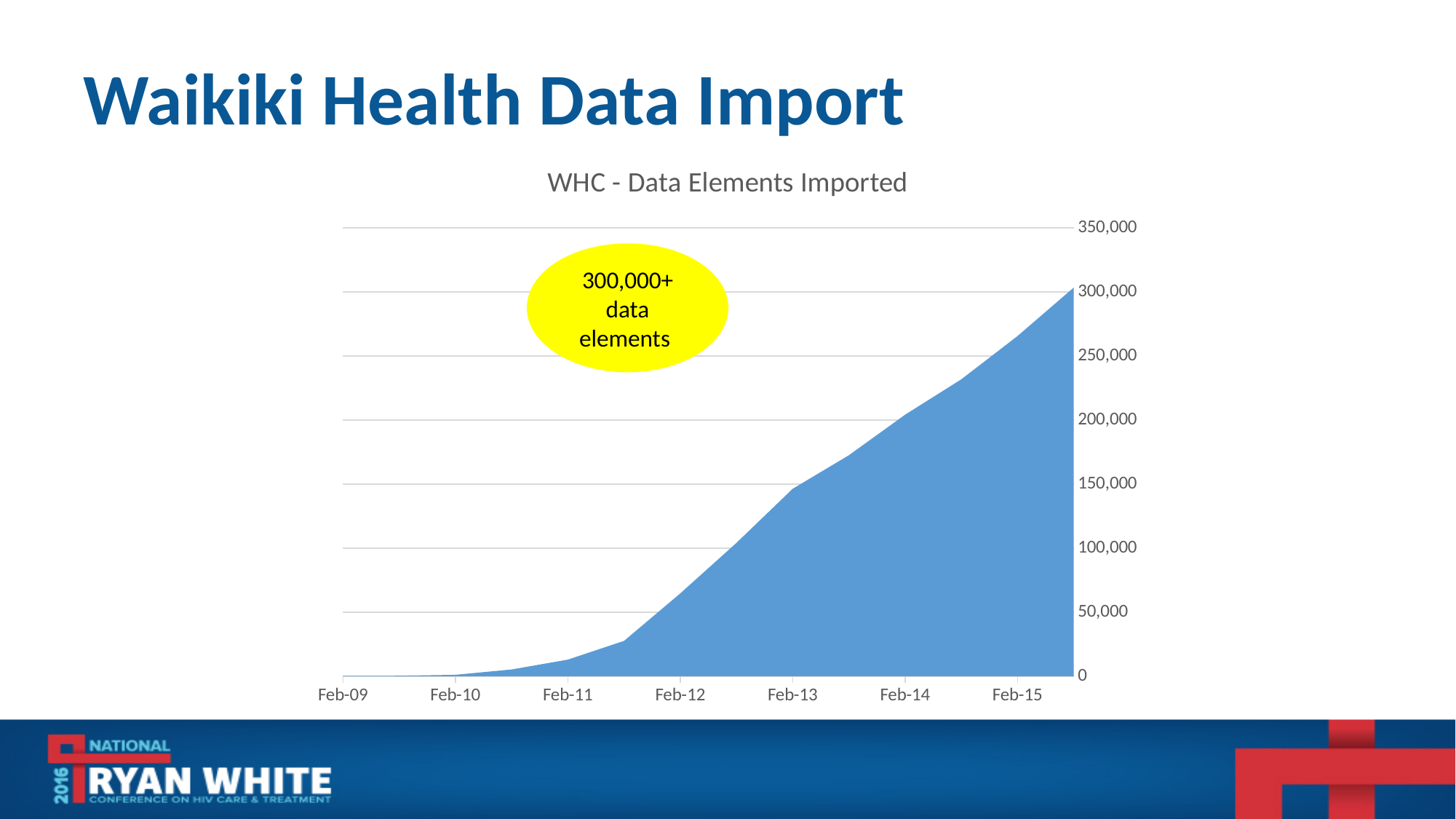
How many date labels are shown on the x axis? 7 Which x-axis label has the lowest value? Feb-09 Is the value at Feb-15 greater or less than 250,000? greater What kind of chart is shown on the slide? area chart Is the value at Feb-10 greater or less than 50,000? less Is the value at Feb-11 greater or less than 50,000? less Do the values rise or fall from Feb-09 to Feb-15? rise Which x-axis label has the highest value? Feb-15 What is the title of the chart? WHC - Data Elements Imported Which is larger, the value at Feb-12 or the value at Feb-14? Feb-14 What is the highest value shown on the y axis? 350,000